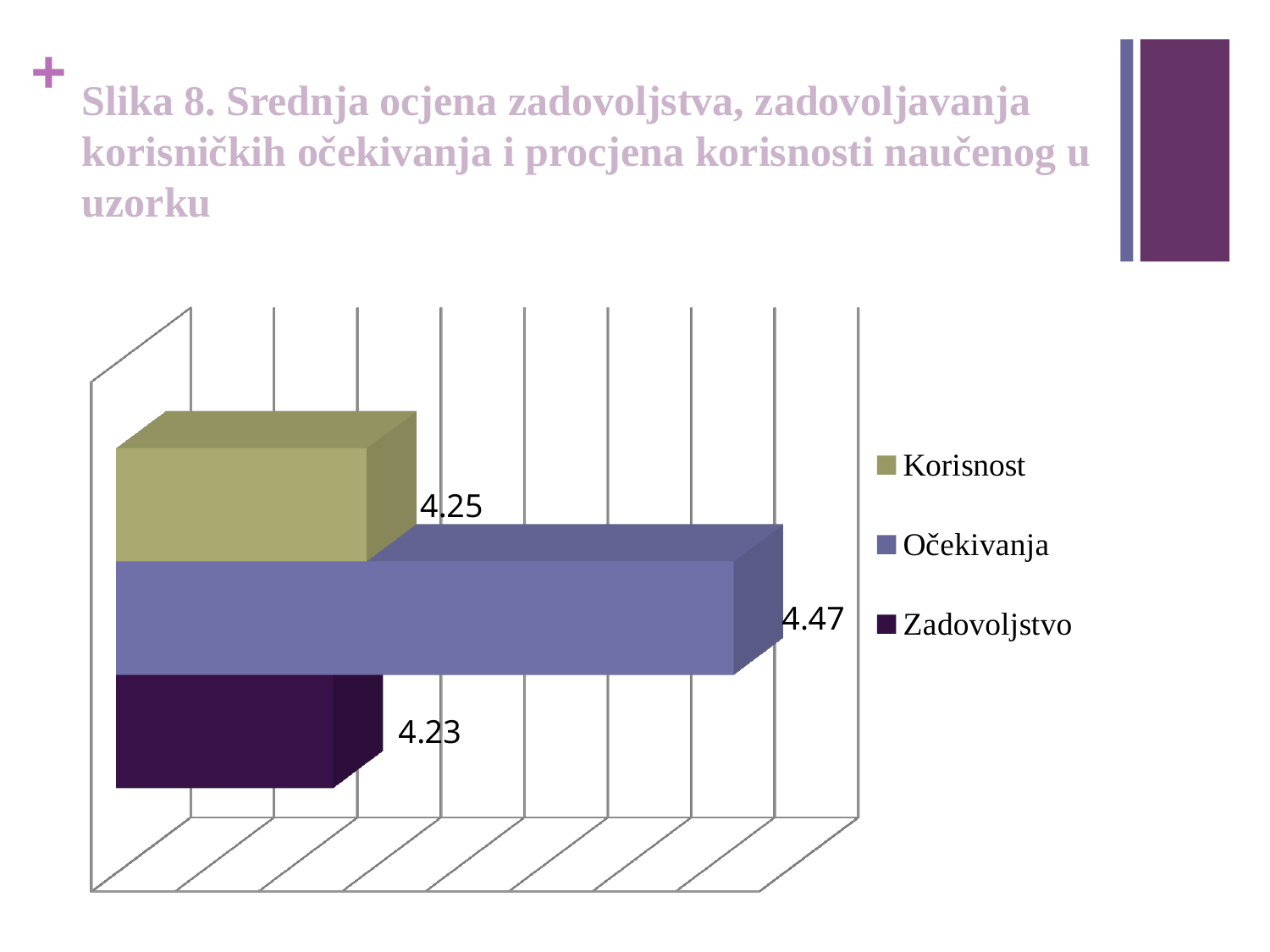
Which is larger, the value for Očekivanja or the value for Korisnost? Očekivanja Which legend entry is shown in the olive/khaki colour? Korisnost What is the value shown for Očekivanja? 4.47 How many series does the legend list? 3 What is the difference between the values for Očekivanja and Korisnost? 0.22 What kind of chart is shown on the slide? Bar chart What is the value shown for Zadovoljstvo? 4.23 Which series has the highest value? Očekivanja What is the value shown for Korisnost? 4.25 Which series has the lowest value according to the data labels? Zadovoljstvo What is the difference between the values for Očekivanja and Zadovoljstvo? 0.24 How many bars are plotted in the chart? 3